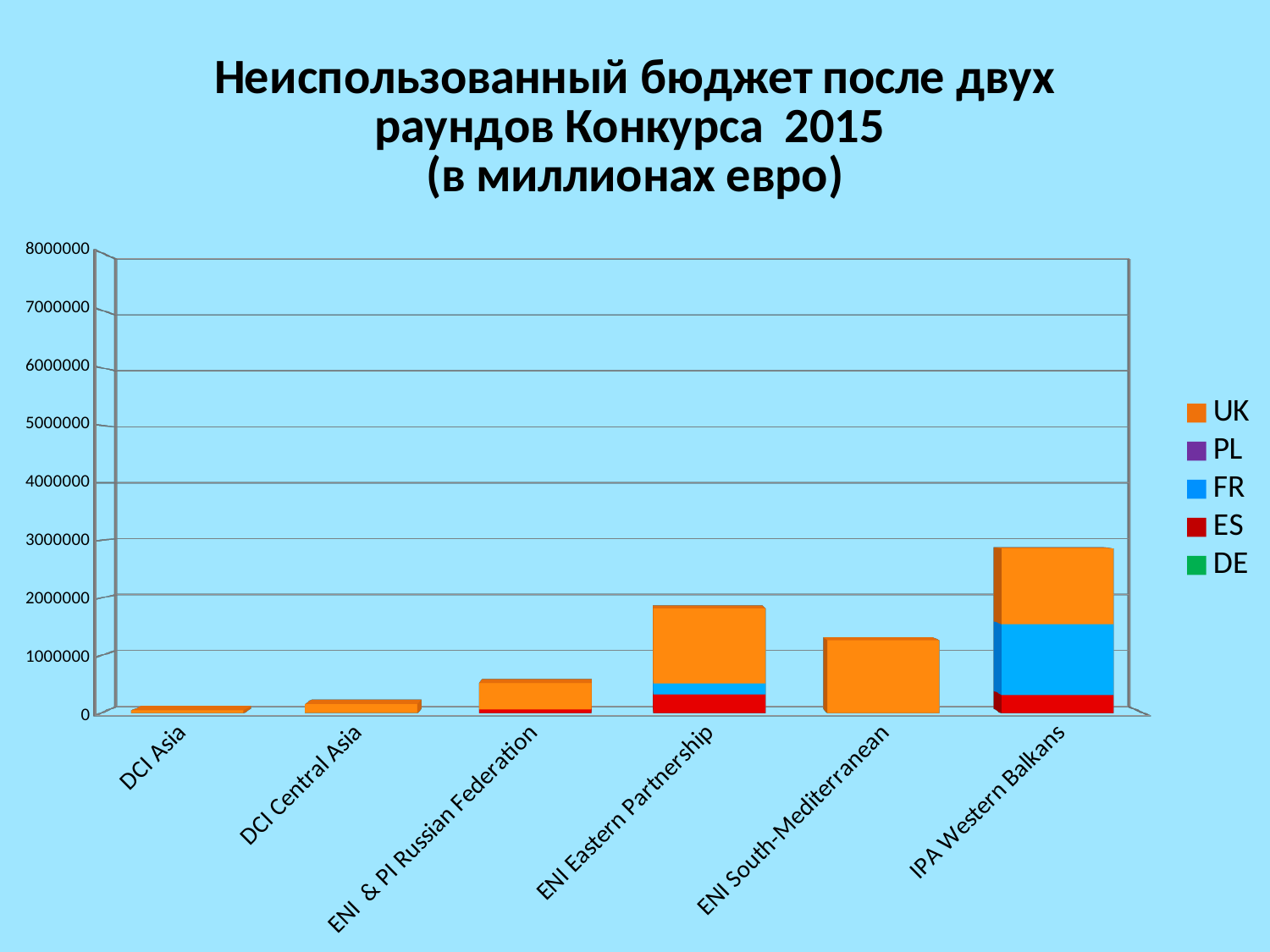
Is the total value for ENI Eastern Partnership greater or less than 2000000? less What kind of chart is shown on the slide? stacked bar chart How many categories are shown on the x axis of the chart? 6 Is the total value for ENI & PI Russian Federation greater or less than 1000000? less Which category has the highest total bar? IPA Western Balkans Which series is shown in orange in the legend? UK Which category has the lowest total bar? DCI Asia How many series does the chart's legend list? 5 Which has the larger total bar, DCI Asia or DCI Central Asia? DCI Central Asia Is the total value for ENI South-Mediterranean greater or less than 1000000? greater Which has the larger total bar, ENI Eastern Partnership or ENI South-Mediterranean? ENI Eastern Partnership